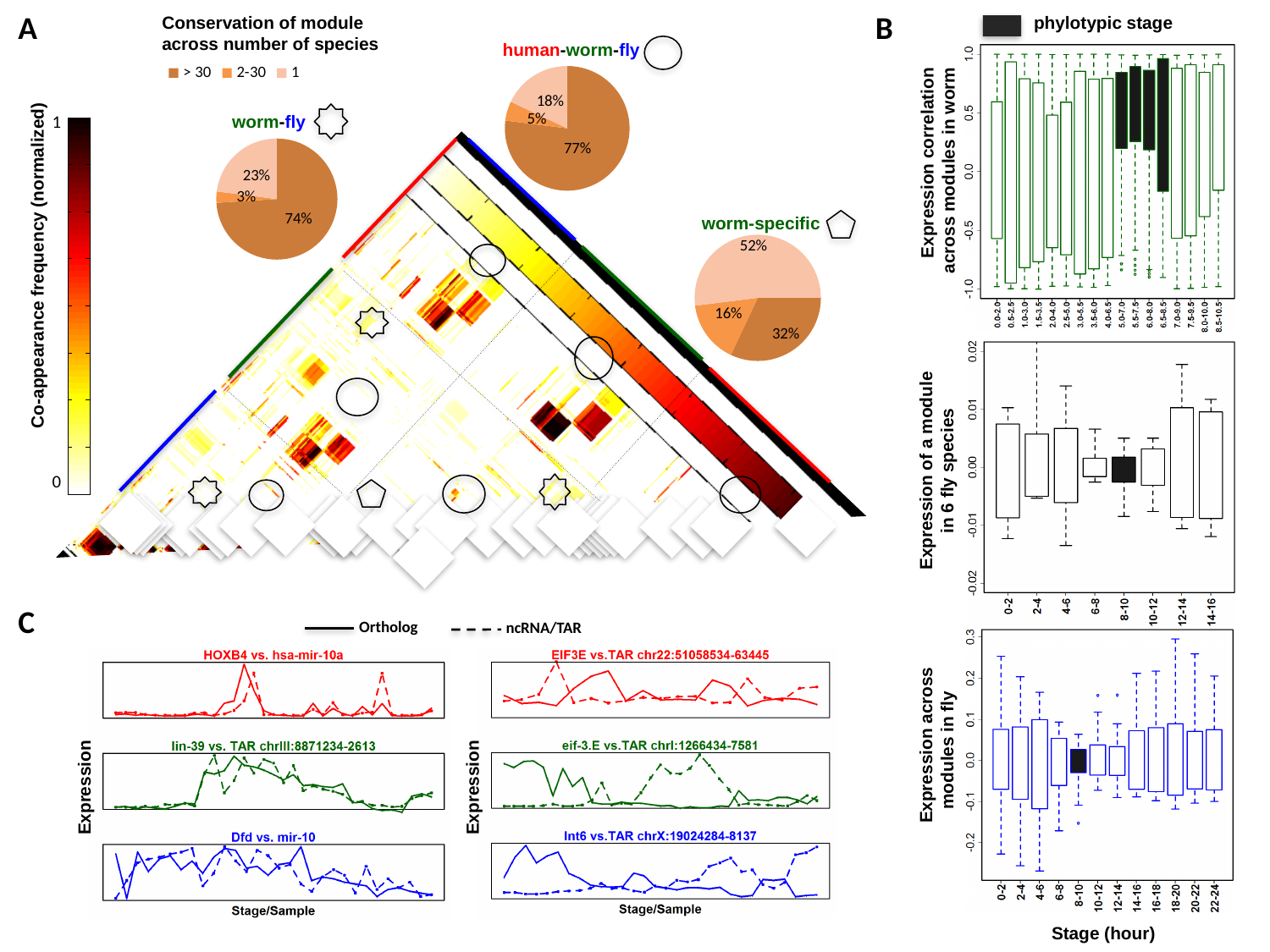
In the middle box plot of panel B (Expression of a module in 6 fly species), how many stage categories are on the x axis? 8 In the worm-specific pie chart, which conservation category has the largest slice? 1 In the human-worm-fly pie chart, which conservation category has the largest slice? > 30 How many pie charts are shown in panel A? 3 What two line styles does the legend in panel C distinguish? Ortholog (solid) and ncRNA/TAR (dashed) In the bottom box plot of panel B (Expression across modules in fly), how many stage categories are on the x axis? 12 In the worm-fly pie chart, which slice is larger: the 1 species slice or the 2-30 species slice? 1 species (23%) What is the difference between the > 30 species share in the human-worm-fly pie chart (77%) and in the worm-fly pie chart (74%)? 3 percentage points What kind of chart is the worm-specific chart in panel A? Pie chart In the human-worm-fly pie chart, what percentage is shown for the 1 species category? 18% In the worm-fly pie chart, what share of modules is conserved across more than 30 species? 74% In the worm-specific pie chart, what percentage is shown for the 2-30 species category? 16%